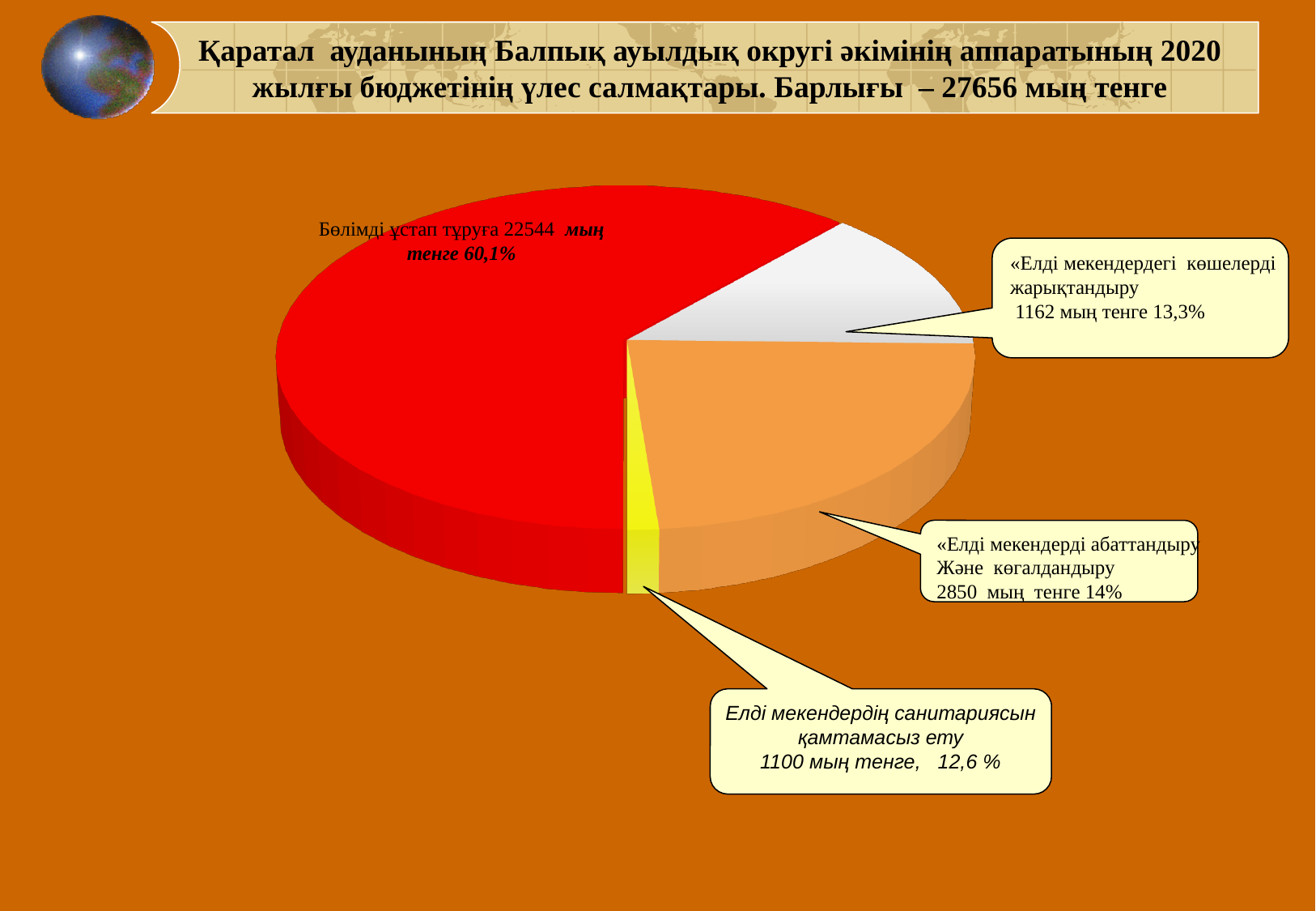
Which is larger: "Елді мекендерді абаттандыру және көгалдандыру" or "Елді мекендердегі көшелерді жарықтандыру"? Елді мекендерді абаттандыру және көгалдандыру What value is shown for "Елді мекендерді абаттандыру және көгалдандыру"? 2850 мың тенге What share of the pie is labelled for "Бөлімді ұстап тұруға"? 60,1% What value is shown for "Елді мекендердің санитариясын қамтамасыз ету"? 1100 мың тенге What share of the pie is labelled for "Елді мекендерді абаттандыру және көгалдандыру"? 14% How many slices does the pie chart have? 4 What kind of chart is shown on the slide? pie chart Which category has the largest slice of the pie? Бөлімді ұстап тұруға What value is shown for "Бөлімді ұстап тұруға"? 22544 мың тенге Which category has the smallest slice of the pie? Елді мекендердің санитариясын қамтамасыз ету What is the difference between the values for "Елді мекендерді абаттандыру және көгалдандыру" and "Елді мекендердің санитариясын қамтамасыз ету"? 1750 мың тенге What value is shown for "Елді мекендердегі көшелерді жарықтандыру"? 1162 мың тенге